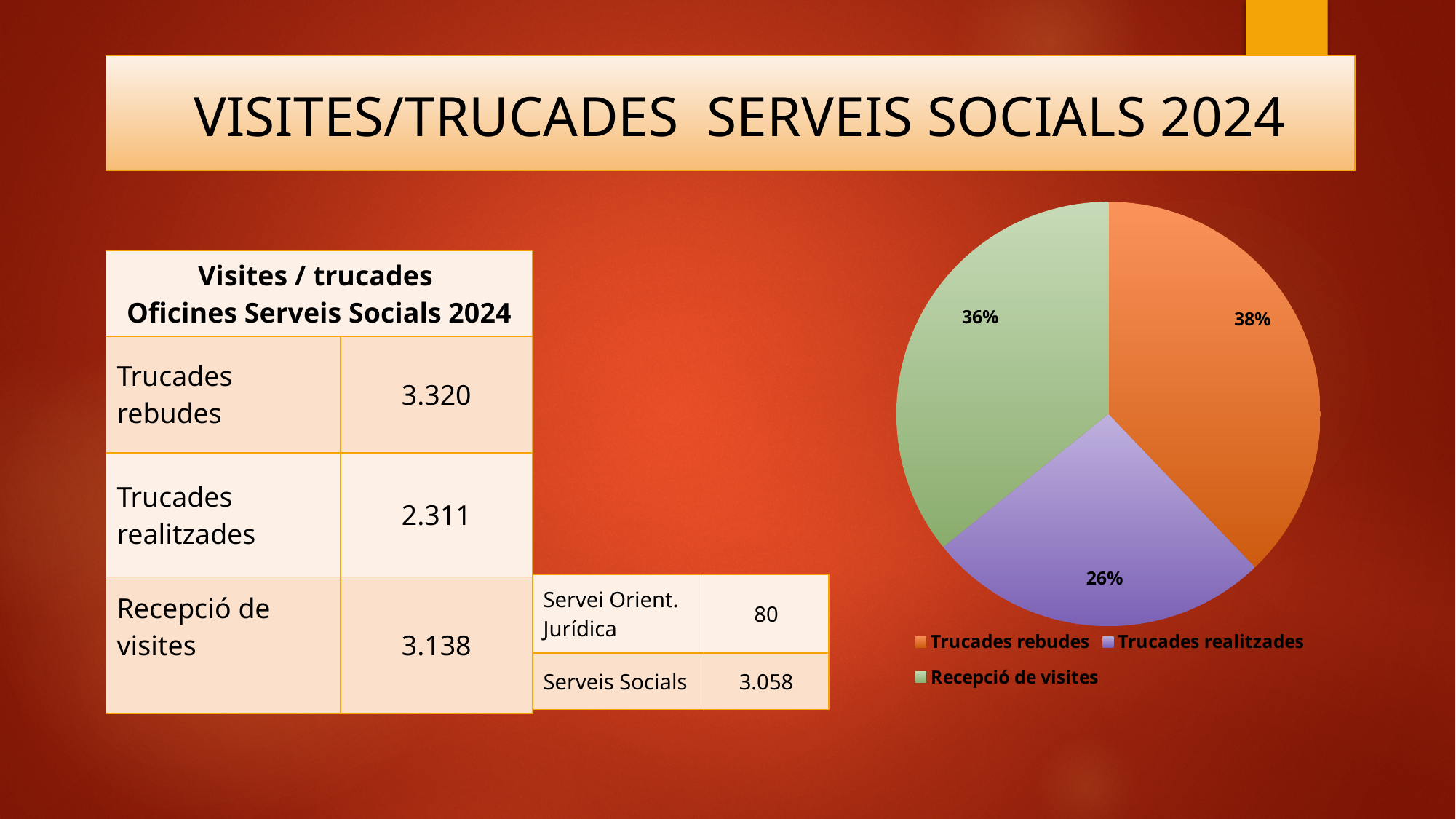
How many entries does the pie chart legend list? 3 Which slice of the pie chart is the smallest? Trucades realitzades In the pie chart, what is the difference in percentage points between Recepció de visites and Trucades realitzades? 10 Which slice of the pie chart is the largest? Trucades rebudes What share of the pie chart does Trucades realitzades represent? 26% What share of the pie chart does Trucades rebudes represent? 38% What colour is the Recepció de visites slice in the pie chart? green What share of the pie chart does Recepció de visites represent? 36% In the pie chart, what is the difference in percentage points between Trucades rebudes and Trucades realitzades? 12 In the pie chart, which is larger: Recepció de visites or Trucades realitzades? Recepció de visites How many slices does the pie chart have? 3 What kind of chart is shown on the slide? pie chart